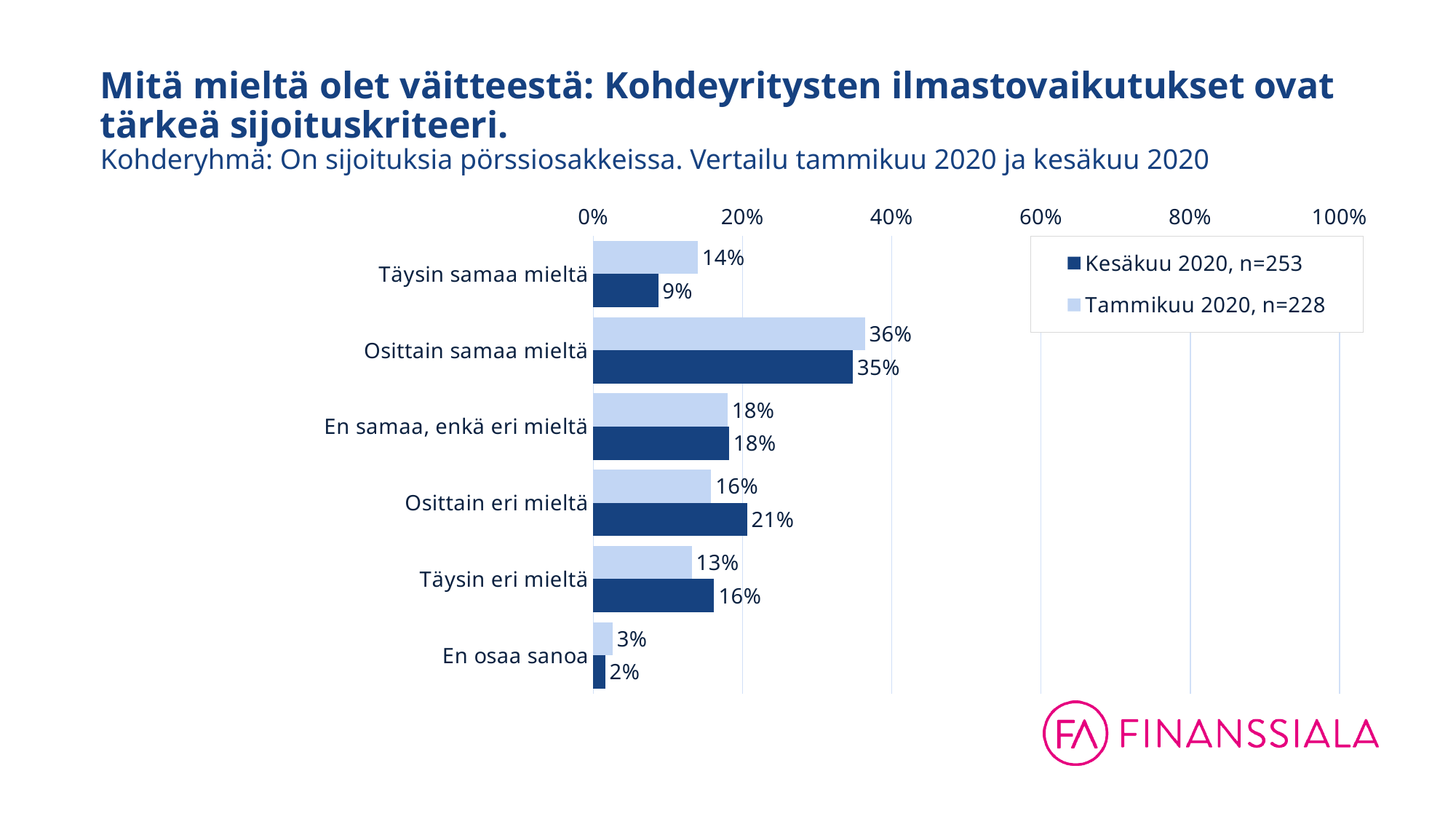
For "Täysin eri mieltä", which series has the larger value, Kesäkuu 2020 or Tammikuu 2020? Kesäkuu 2020 How many categories are shown on the chart? 6 Which category has the lowest value in the Kesäkuu 2020, n=253 series? En osaa sanoa What kind of chart is shown on the slide? Bar chart Which category has the highest value in the Tammikuu 2020, n=228 series? Osittain samaa mieltä What is the value for "Osittain samaa mieltä" in the Kesäkuu 2020, n=253 series? 35% What is the value for "Osittain eri mieltä" in the Kesäkuu 2020, n=253 series? 21% Is the Kesäkuu 2020 value for "Osittain samaa mieltä" greater or less than 20%? greater What is the difference between the Kesäkuu 2020 and Tammikuu 2020 values for "Täysin samaa mieltä"? 5% How many series does the legend list? 2 What is the sample size (n) given in the legend for the Kesäkuu 2020 series? 253 What is the value for "Täysin samaa mieltä" in the Tammikuu 2020, n=228 series? 14%